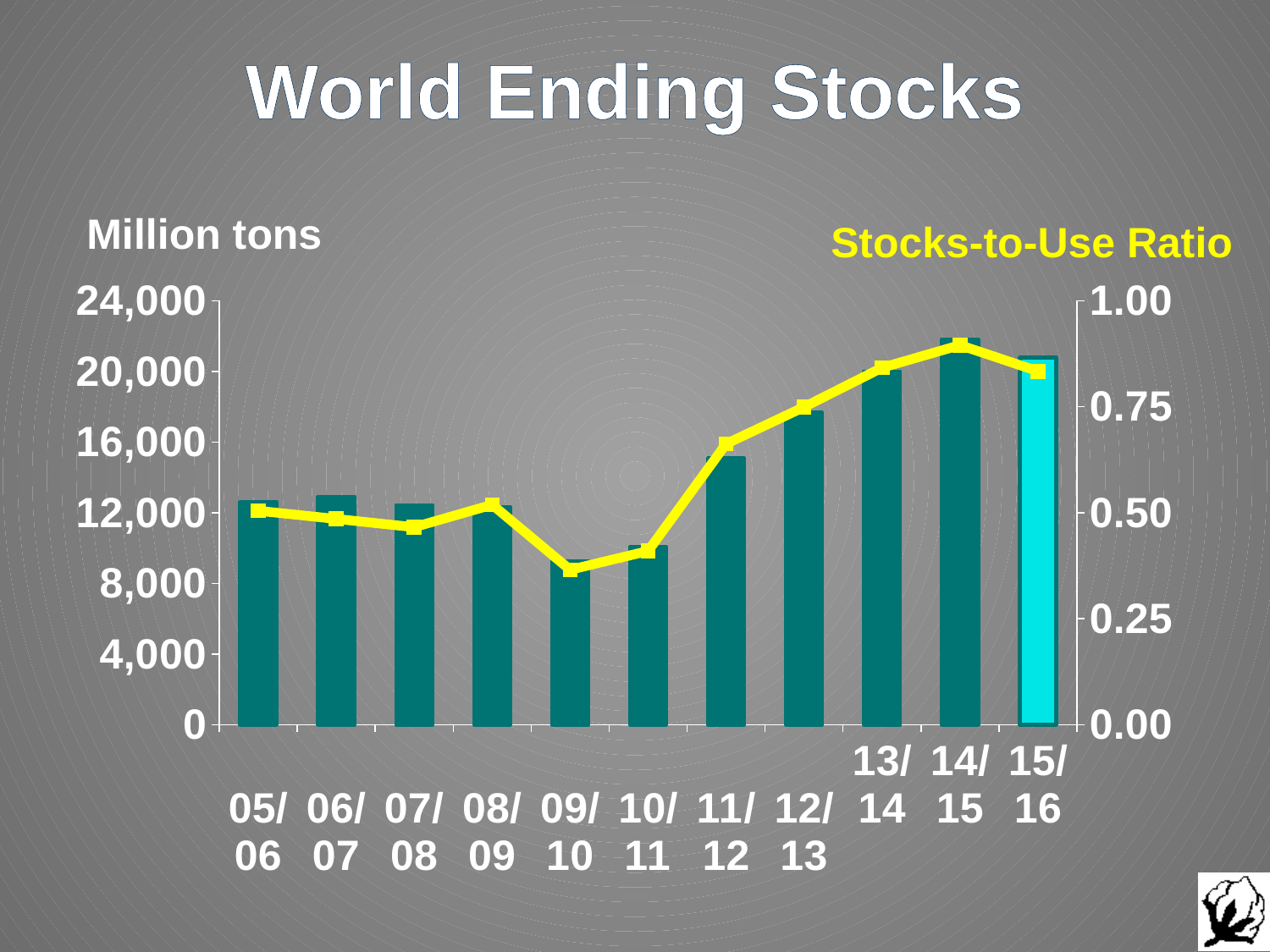
Which year has the tallest bar for world ending stocks? 14/15 What is the title of the chart? World Ending Stocks Which year has the shortest bar for world ending stocks? 09/10 Is the stocks-to-use ratio for 14/15 greater or less than 0.75? greater Is the ending stocks bar for 14/15 greater or less than 20,000 million tons? greater What does the right-hand axis of the chart measure? Stocks-to-Use Ratio Which year has the larger ending stocks bar, 11/12 or 12/13? 12/13 Is the stocks-to-use ratio for 09/10 greater or less than 0.50? less How many marketing years are shown on the x axis? 11 What kind of chart is shown on the slide? A combined bar and line chart Do the ending stocks bars rise or fall from 10/11 to 14/15? rise